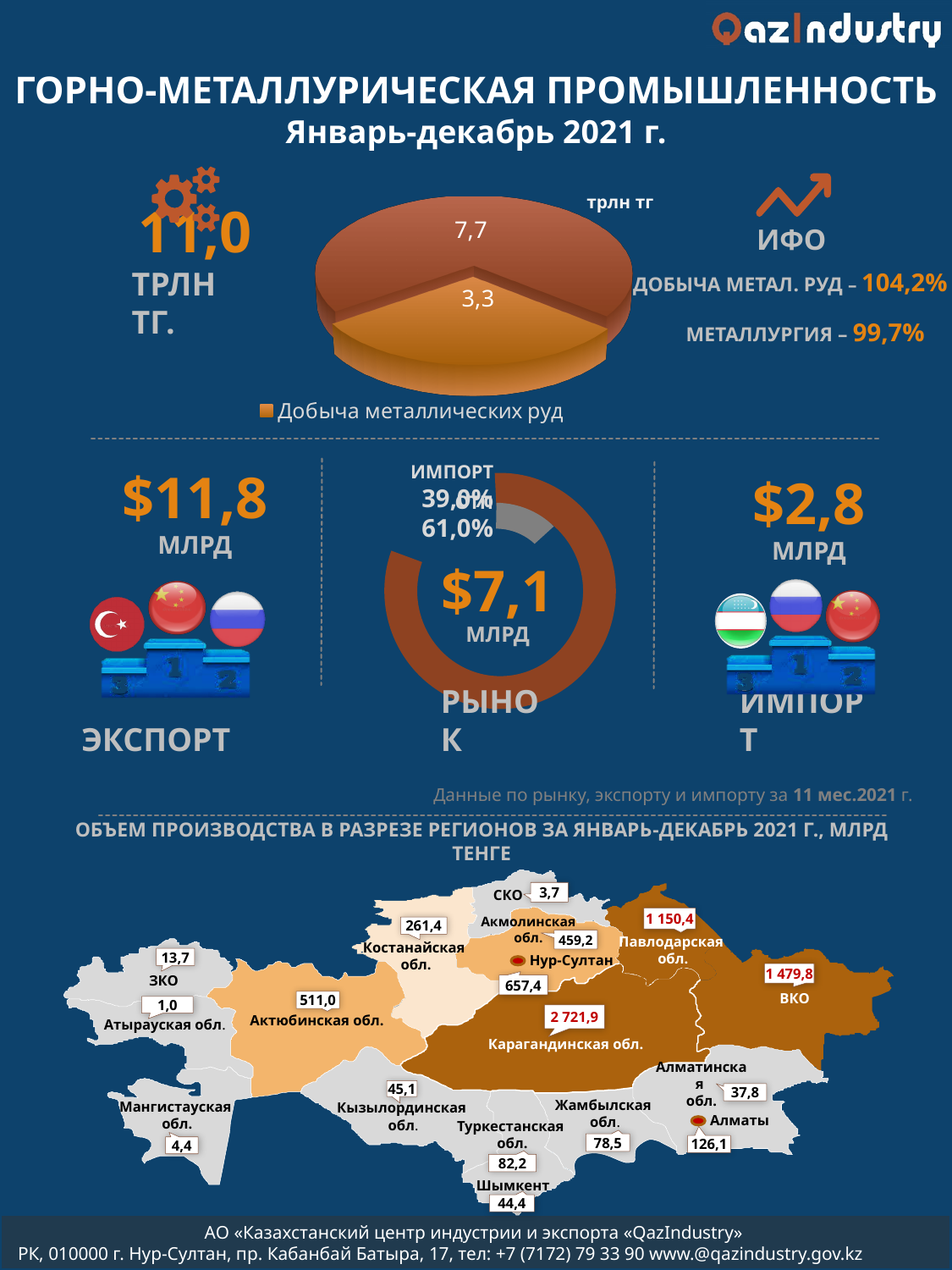
On the pie chart at the top of the slide, what is the value of the smaller slice? 3,3 What kind of chart is shown at the top of the slide next to the '11,0 ТРЛН ТГ' figure? Pie chart On the pie chart at the top of the slide, what is the total of the two slices? 11,0 On the regional map chart, what is the production volume for ВКО? 1 479,8 On the regional map chart, which region has the lowest production volume? Атырауская обл. On the pie chart at the top of the slide, what is the difference between the two slice values? 4,4 On the regional map chart, which region has the highest production volume? Карагандинская обл. What value is printed in the centre of the donut chart labelled 'РЫНОК'? $7,1 млрд How many slices does the pie chart at the top of the slide have? 2 On the pie chart at the top of the slide, what is the value of the larger slice? 7,7 What legend entry is shown below the pie chart at the top of the slide? Добыча металлических руд On the regional map chart, which is larger: the value for Павлодарская обл. or the value for Актюбинская обл.? Павлодарская обл.